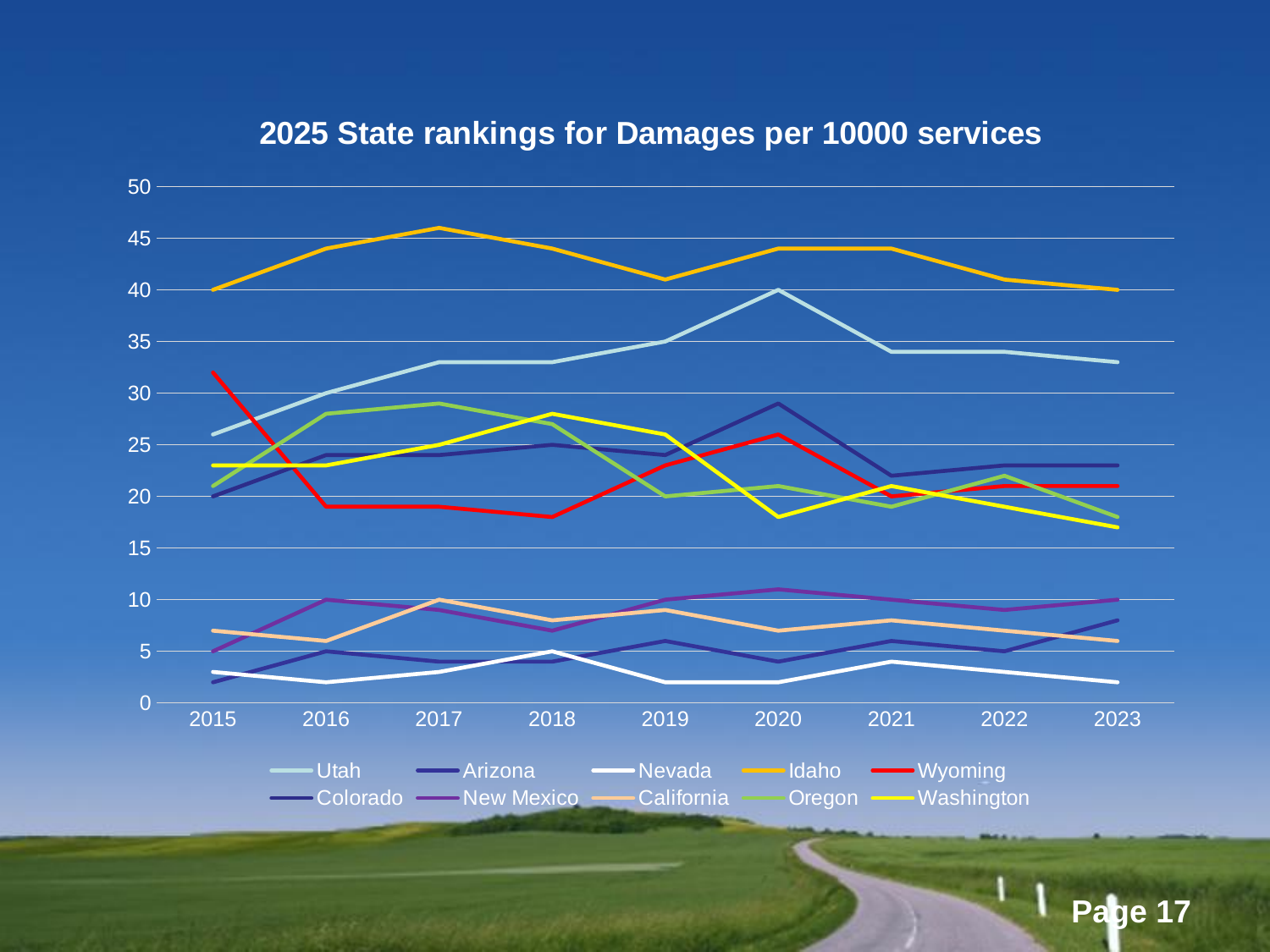
What is the value for Utah in 2020? 40 In 2021, which is larger: the value for Utah or the value for Arizona? Utah How many states does the legend list? 10 What is the title of the chart? 2025 State rankings for Damages per 10000 services How many years are shown along the x axis? 9 Which state has the lowest value in 2023? Nevada Which state has the highest value in 2020? Idaho Is the value for Wyoming in 2015 greater or less than 30? greater What is the value for Idaho in 2015? 40 Does the value for Utah rise or fall from 2020 to 2023? fall What kind of chart is shown on the slide? line chart Is the value for Idaho in 2017 greater or less than 45? greater